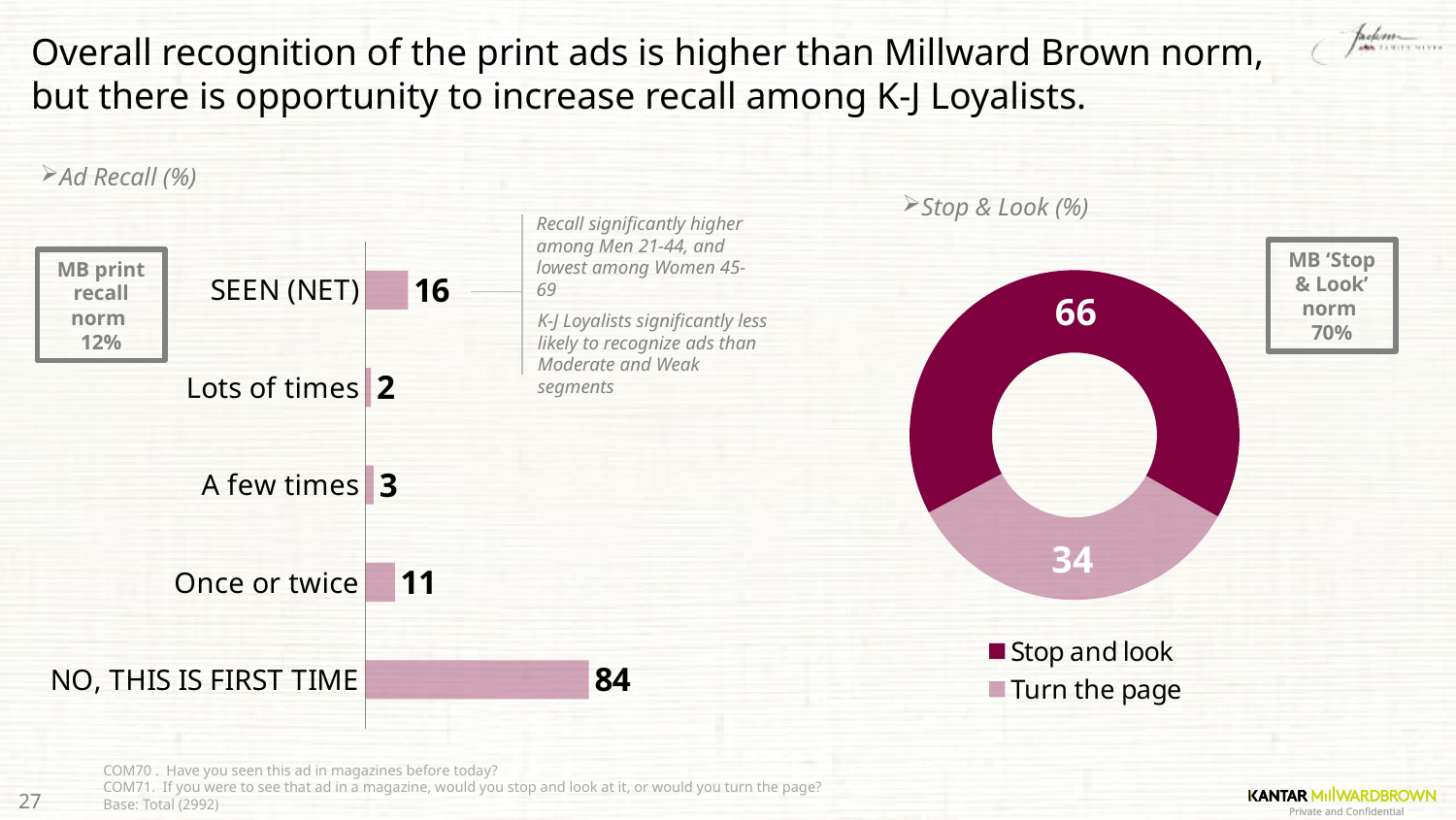
In the Ad Recall (%) chart, what is the value for SEEN (NET)? 16 In the Stop & Look (%) chart, what is the value for Turn the page? 34 What kind of chart is the Ad Recall (%) chart? Bar chart In the Stop & Look (%) chart, what is the value for Stop and look? 66 In the Ad Recall (%) chart, which category has the highest value? NO, THIS IS FIRST TIME In the Ad Recall (%) chart, what is the difference between the values for Once or twice and A few times? 8 In the Ad Recall (%) chart, how many categories are shown? 5 In the Ad Recall (%) chart, what is the value for NO, THIS IS FIRST TIME? 84 How many entries does the legend of the Stop & Look (%) chart list? 2 In the Ad Recall (%) chart, which category has the lowest value? Lots of times In the Ad Recall (%) chart, what is the value for Once or twice? 11 In the Stop & Look (%) chart, which is larger, Stop and look or Turn the page? Stop and look